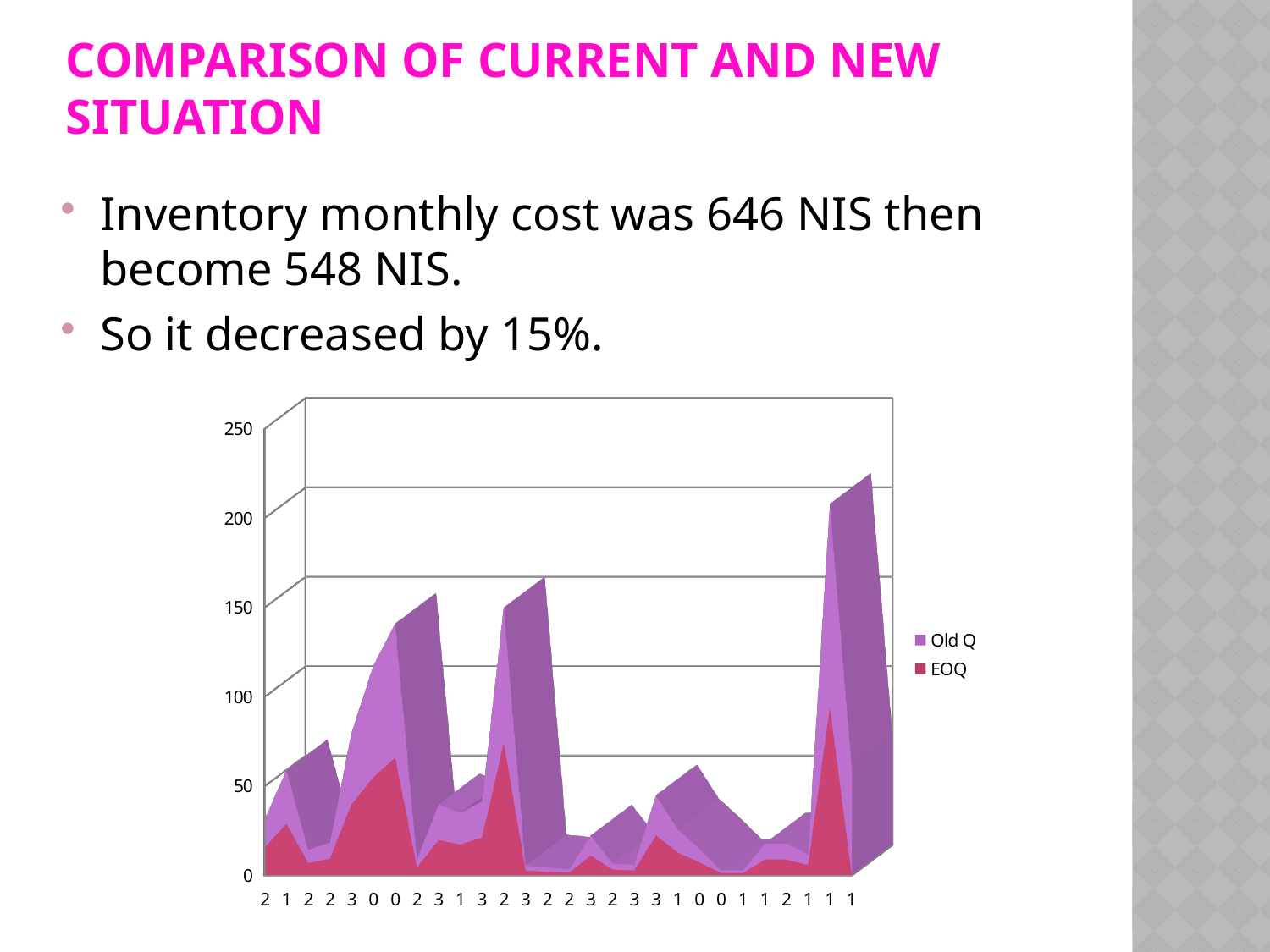
What is the highest value shown on the chart's vertical axis? 250 At which end of the x axis does the Old Q series reach its highest peak? The right end Which series reaches the highest value in the chart, Old Q or EOQ? Old Q What are the names of the two series in the chart's legend? Old Q and EOQ Which colour represents the Old Q series in the chart? Purple How many data points are plotted along the x axis of the chart? 28 Is the highest value of the EOQ series greater or less than 150? less What kind of chart is shown on the slide? Area chart How many series does the chart's legend list? 2 Is the lowest value of the EOQ series greater or less than 50? less